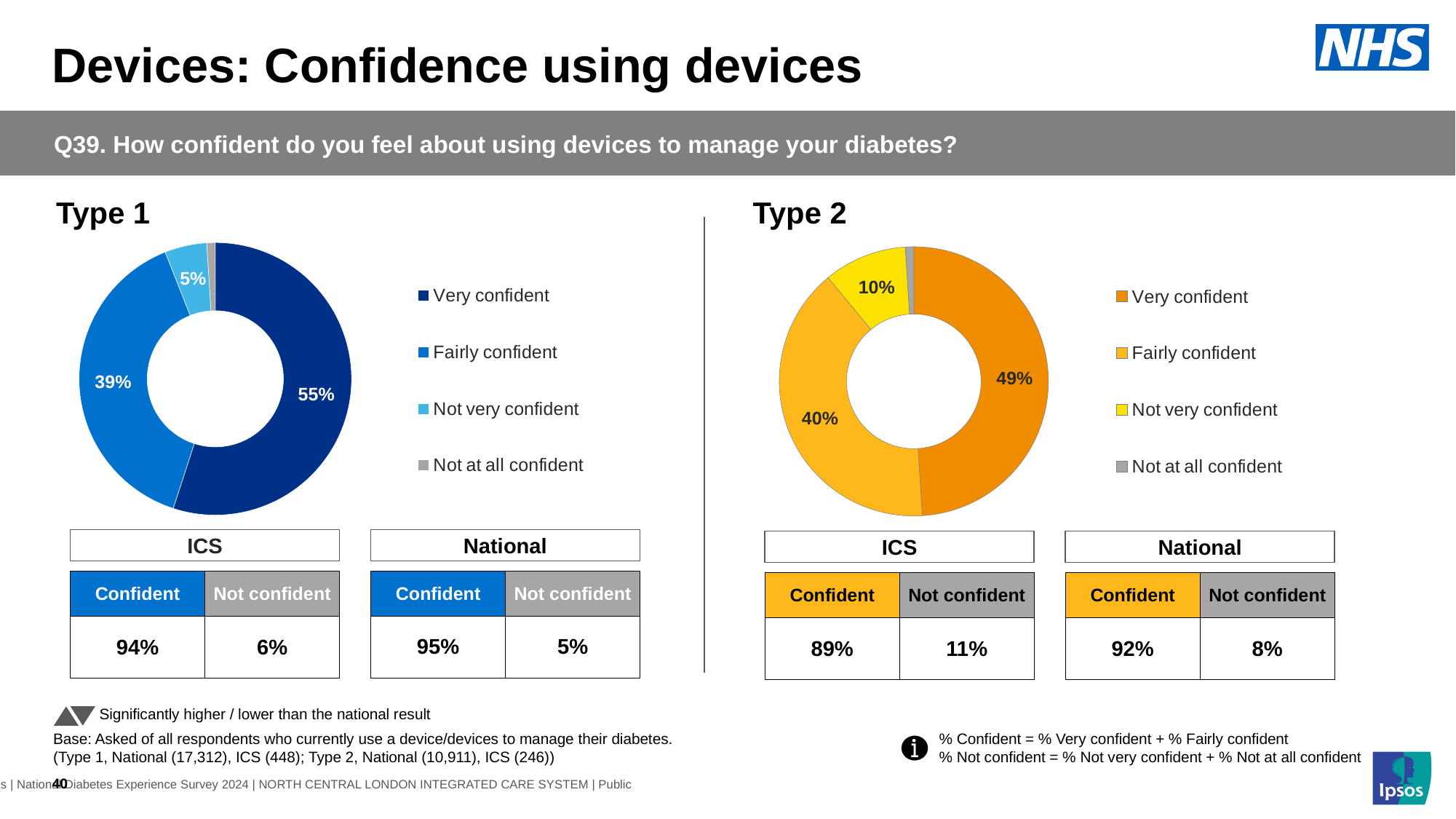
What kind of chart is used for Type 1? Pie (donut) chart In the Type 2 chart, what percentage of respondents are very confident? 49% In the Type 2 chart, which category has the smallest share? Not at all confident In the Type 2 chart, what percentage of respondents are not very confident? 10% In the Type 1 chart, what percentage of respondents are very confident? 55% In the Type 2 chart, what percentage of respondents are fairly confident? 40% In the Type 1 chart, what is the difference between the Very confident and Fairly confident shares? 16 percentage points How many categories does the legend of the Type 2 chart list? 4 In the Type 1 chart, which category has the largest share? Very confident In the Type 1 chart, what percentage of respondents are not very confident? 5% Is the Not very confident share larger in the Type 1 chart or the Type 2 chart? Type 2 In the Type 1 chart, what percentage of respondents are fairly confident? 39%